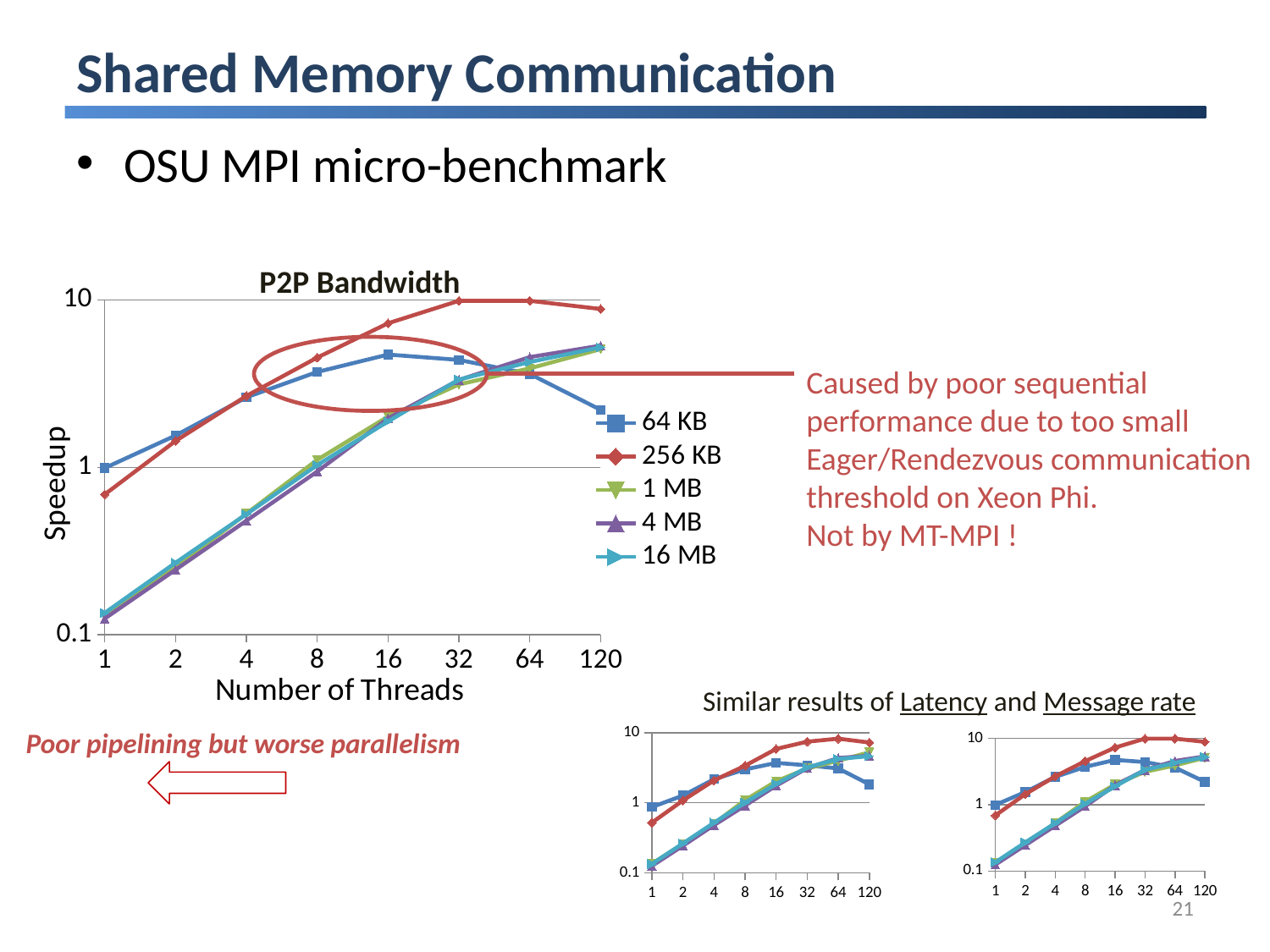
What is the y-axis label of the P2P Bandwidth chart? Speedup What kind of chart is the P2P Bandwidth chart? line chart In the P2P Bandwidth chart, at 120 threads, which is larger: the speedup for 256 KB or for 64 KB? 256 KB How many thread counts are shown on the x axis of the P2P Bandwidth chart? 8 How many series does the legend of the P2P Bandwidth chart list? 5 In the P2P Bandwidth chart, is the speedup for 4 MB at 4 threads greater or less than 1? less In the P2P Bandwidth chart, which series has the highest speedup at 1 thread? 64 KB In the P2P Bandwidth chart, is the speedup for 256 KB at 16 threads greater or less than 1? greater What is the title of the large chart on the slide? P2P Bandwidth In the P2P Bandwidth chart, is the speedup for 16 MB at 1 thread greater or less than 1? less In the P2P Bandwidth chart, does the 64 KB series rise or fall from 16 threads to 120 threads? fall In the P2P Bandwidth chart, which series has the highest speedup at 64 threads? 256 KB